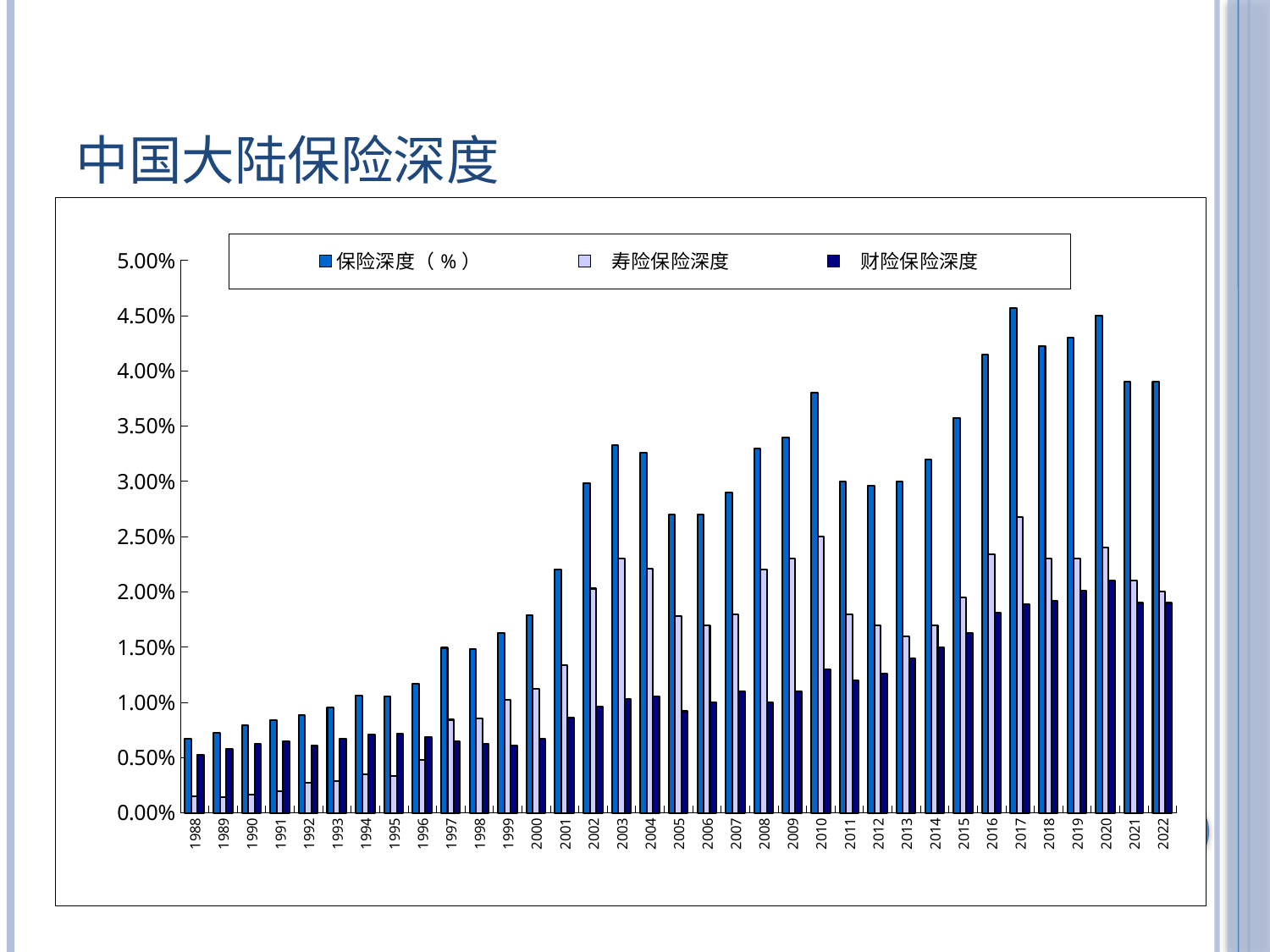
Which is larger, 保险深度（%） in 2010 or in 2011? 2010 What kind of chart is shown on the slide? bar chart Is the value of 保险深度（%） for 2010 greater or less than 3.50%? greater In which year is 保险深度（%） highest? 2017 Does 保险深度（%） rise or fall from 1988 to 2001? rise Is the value of 寿险保险深度 for 2010 greater or less than 2.00%? greater In which year is 寿险保险深度 highest? 2017 How many series does the legend list? 3 Is the value of 财险保险深度 for 2015 greater or less than 1.50%? greater How many years are shown along the x axis? 35 In which year is 保险深度（%） lowest? 1988